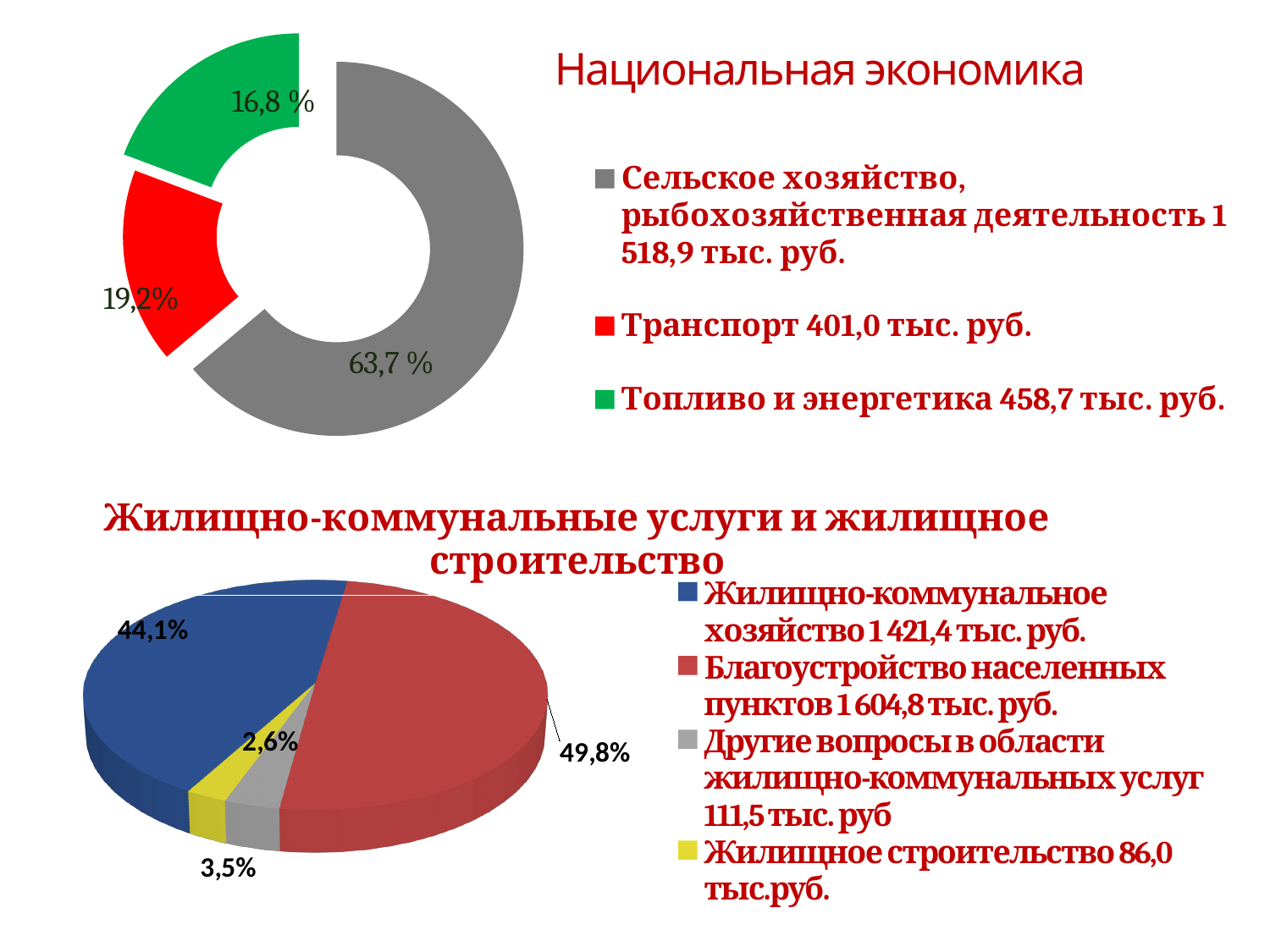
In the 'Национальная экономика' chart, what amount in тыс. руб. is given for Транспорт in the legend? 401,0 тыс. руб. In the 'Национальная экономика' chart, how many categories does the legend list? 3 What kind of chart is the 'Национальная экономика' chart? Doughnut chart In the 'Жилищно-коммунальные услуги и жилищное строительство' chart, how many slices does the pie have? 4 In the 'Национальная экономика' chart, what percentage is shown for Топливо и энергетика? 16,8 % In the 'Жилищно-коммунальные услуги и жилищное строительство' chart, which category has the smallest share? Жилищное строительство In the 'Национальная экономика' chart, what percentage is shown for Транспорт? 19,2% In the 'Жилищно-коммунальные услуги и жилищное строительство' chart, what is the difference in percentage points between Благоустройство населенных пунктов and Жилищно-коммунальное хозяйство? 5,7 In the 'Жилищно-коммунальные услуги и жилищное строительство' chart, what percentage is shown for Жилищное строительство? 2,6% In the 'Жилищно-коммунальные услуги и жилищное строительство' chart, what percentage is shown for Благоустройство населенных пунктов? 49,8% In the 'Национальная экономика' chart, which category has the largest share? Сельское хозяйство, рыбохозяйственная деятельность In the 'Жилищно-коммунальные услуги и жилищное строительство' chart, which colour represents Другие вопросы в области жилищно-коммунальных услуг? Gray